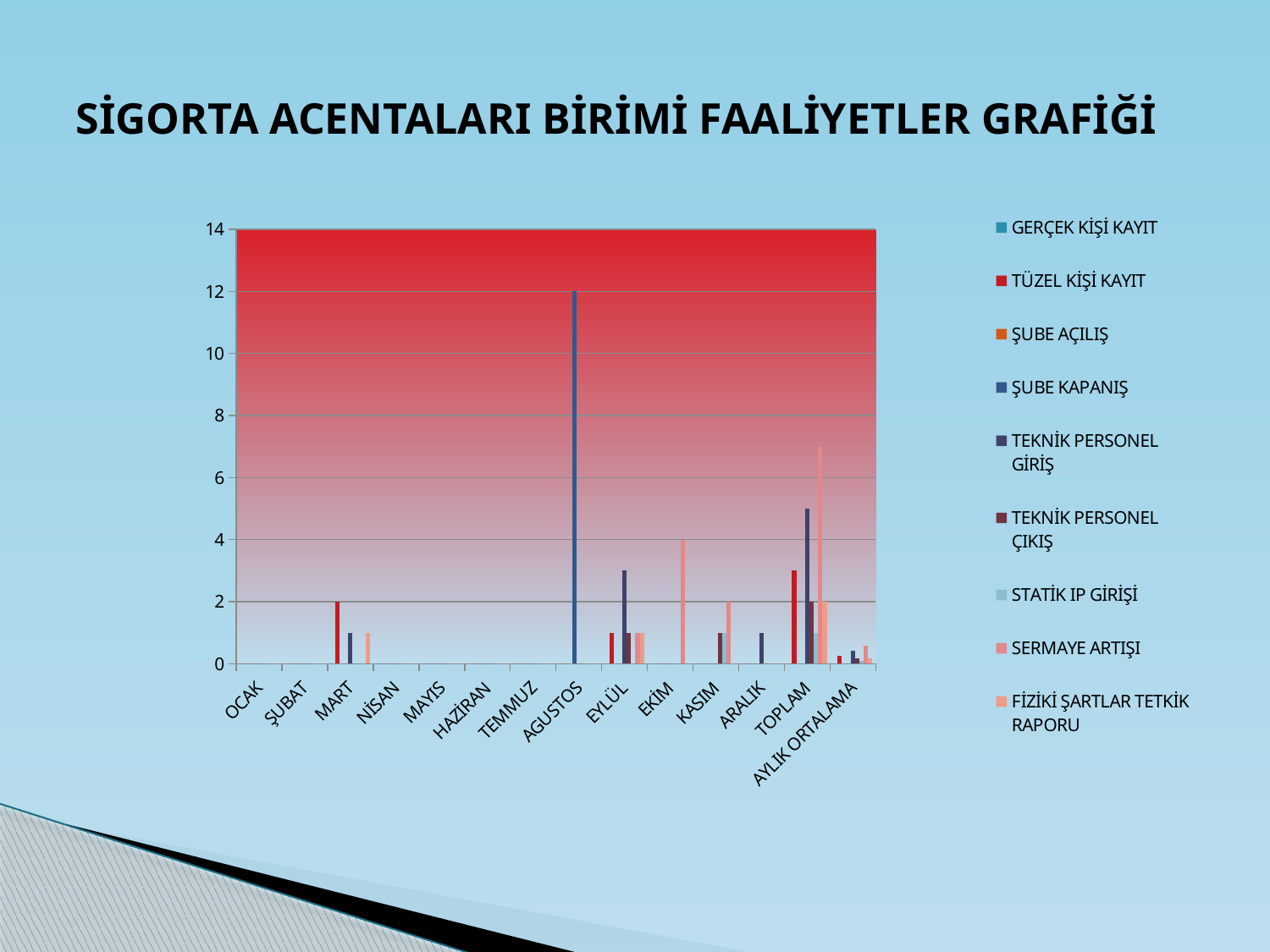
What is the value of the ŞUBE KAPANIŞ bar for AGUSTOS? 12 What is the highest value shown on the chart's vertical axis? 14 Is the value of the SERMAYE ARTIŞI bar for TOPLAM greater or less than 6? greater What is the title of the chart? SİGORTA ACENTALARI BİRİMİ FAALİYETLER GRAFİĞİ How many series does the chart's legend list? 9 Is the value of the TEKNİK PERSONEL GİRİŞ bar for TOPLAM greater or less than 4? greater Which category has the tallest bar in the chart? AGUSTOS What kind of chart is shown on the slide? Bar chart How many categories are shown along the x axis of the chart? 14 Which is larger: the ŞUBE KAPANIŞ bar for AGUSTOS or the TEKNİK PERSONEL GİRİŞ bar for TOPLAM? ŞUBE KAPANIŞ for AGUSTOS What is the value of the TÜZEL KİŞİ KAYIT bar for MART? 2